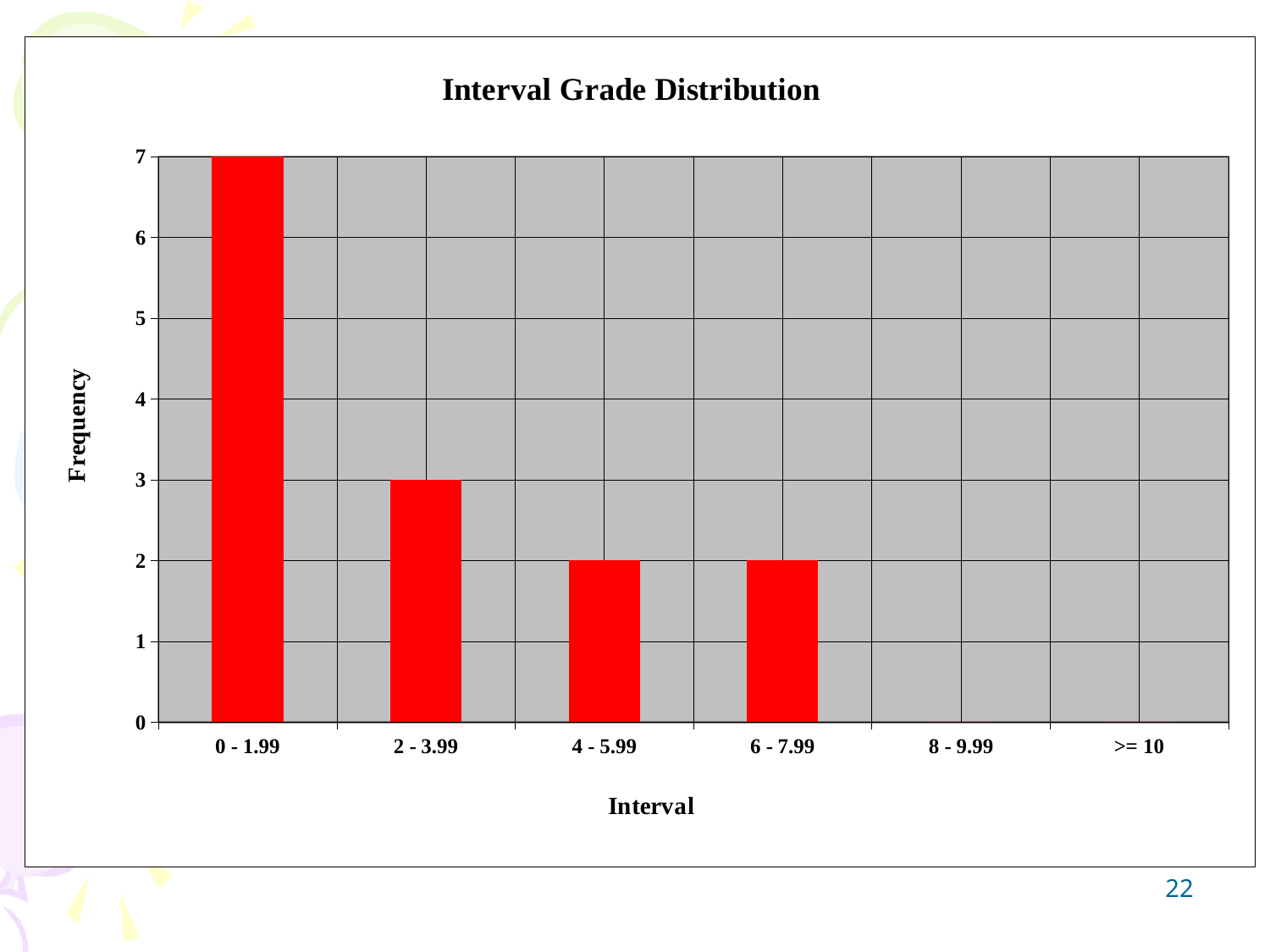
What is the difference in frequency between the 0 - 1.99 interval and the 2 - 3.99 interval? 4 What is the title of the chart? Interval Grade Distribution What is the frequency for the interval 8 - 9.99? 0 What type of chart is shown on the slide? bar chart What is the frequency for the interval 6 - 7.99? 2 What is the frequency for the interval 4 - 5.99? 2 How many intervals are shown on the x axis? 6 What is the frequency for the interval 2 - 3.99? 3 Which has a higher frequency, the 2 - 3.99 interval or the 4 - 5.99 interval? 2 - 3.99 What is the frequency for the interval 0 - 1.99? 7 What is the label of the y axis? Frequency Which interval has the highest frequency? 0 - 1.99